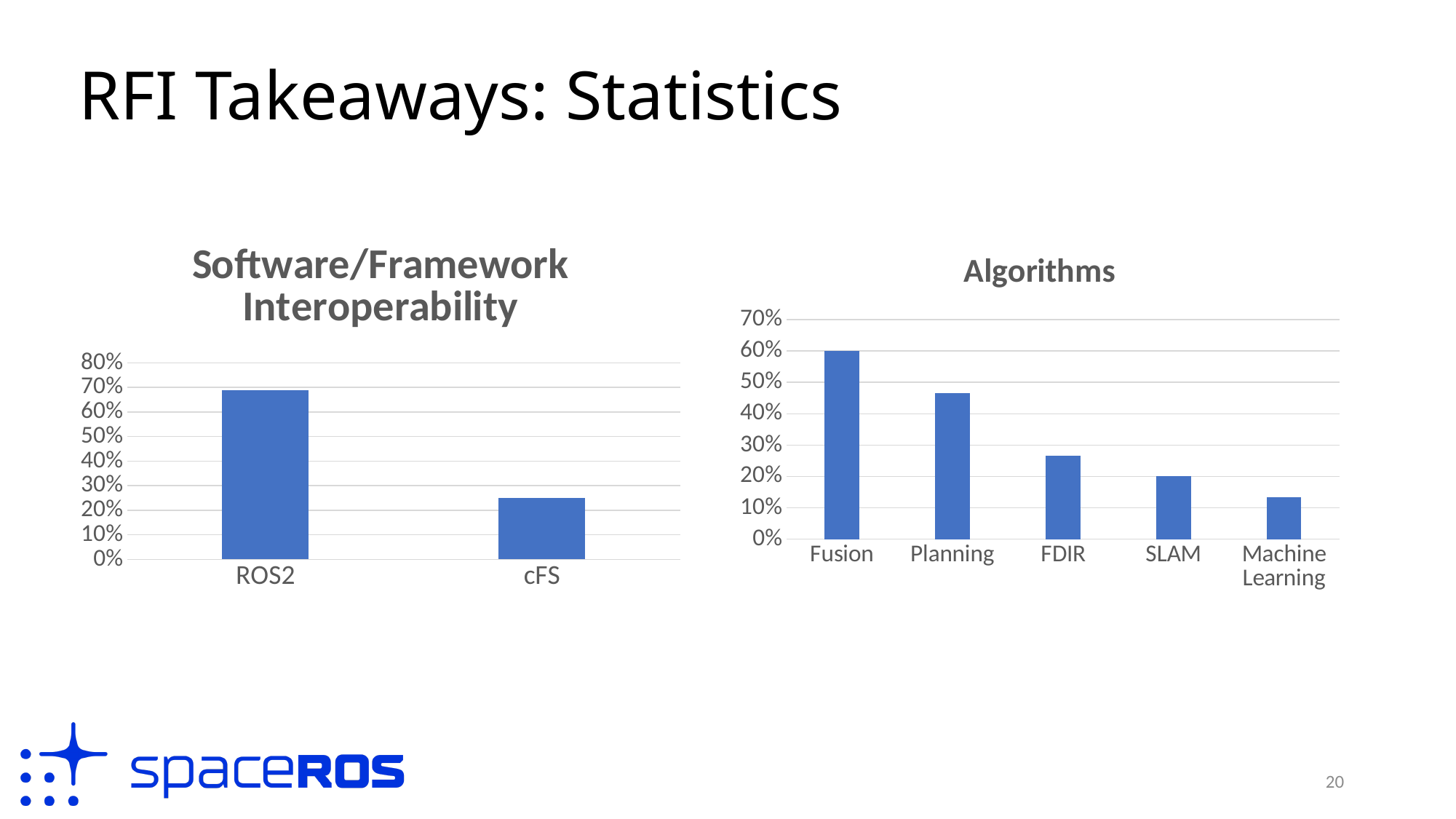
In the Software/Framework Interoperability chart, is the value for ROS2 greater or less than 60%? greater In the Algorithms chart, what is the value for Fusion? 60% How many categories are shown in the Software/Framework Interoperability chart? 2 In the Software/Framework Interoperability chart, which category has the highest value? ROS2 In the Algorithms chart, is the value for Planning greater or less than 40%? greater What kind of chart is the Software/Framework Interoperability chart? bar chart In the Algorithms chart, which is larger, the value for Planning or the value for SLAM? Planning In the Algorithms chart, which category has the highest value? Fusion In the Software/Framework Interoperability chart, is the value for cFS greater or less than 30%? less In the Algorithms chart, which category has the lowest value? Machine Learning In the Algorithms chart, do the values rise or fall from left to right along the x axis? fall